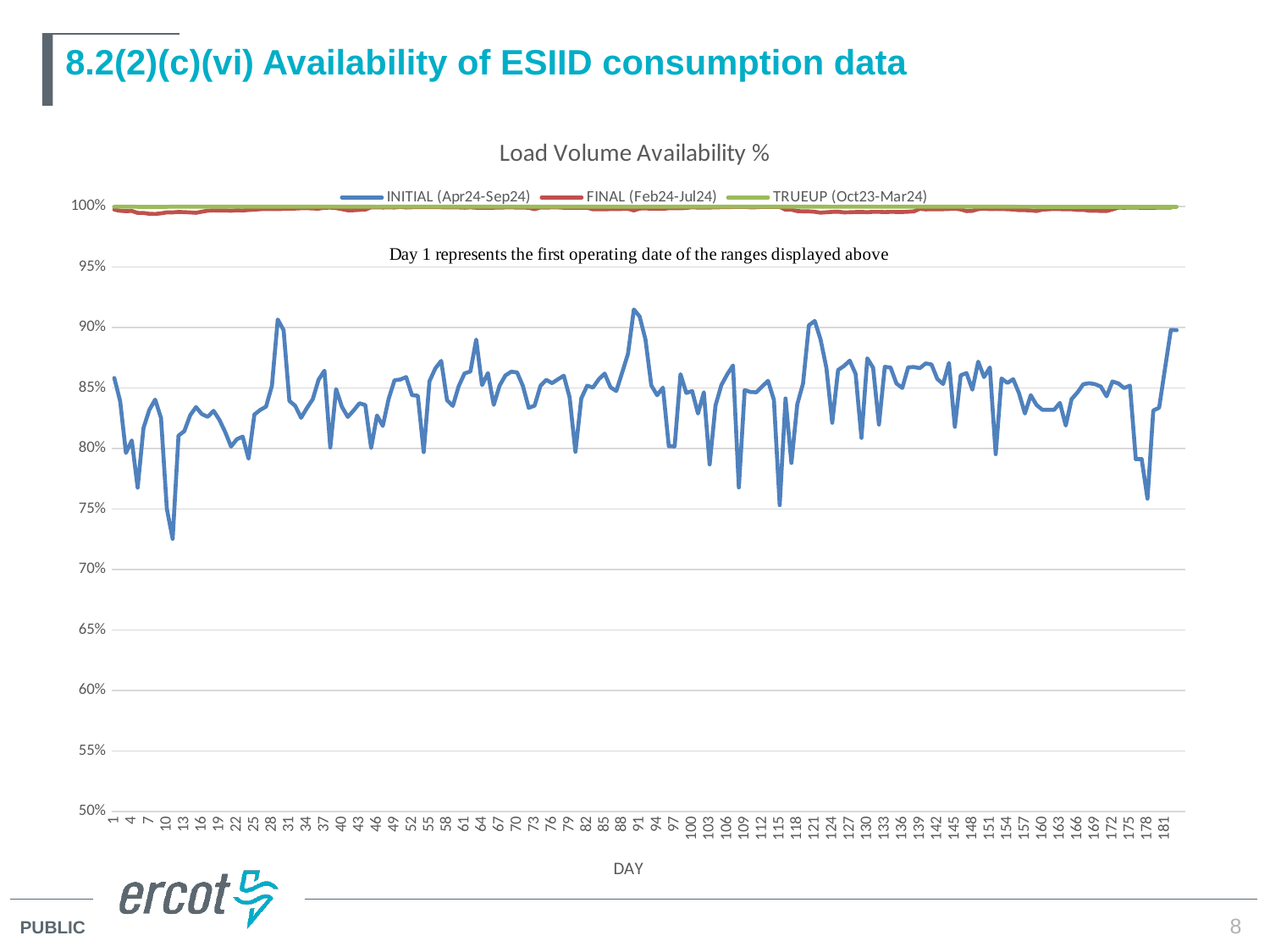
Is the value of the INITIAL (Apr24-Sep24) series at day 178 greater or less than 80%? less What type of chart is shown on the slide? Line chart Which series has the highest values across the chart? TRUEUP (Oct23-Mar24) At day 10, which series has the larger value: INITIAL (Apr24-Sep24) or FINAL (Feb24-Jul24)? FINAL (Feb24-Jul24) Which series has the lowest values across the chart? INITIAL (Apr24-Sep24) Is the value of the INITIAL (Apr24-Sep24) series at day 91 greater or less than 90%? greater What is the title of the chart? Load Volume Availability % Is the value of the FINAL (Feb24-Jul24) series at day 100 greater or less than 95%? greater What is the label of the x axis? DAY How many series does the chart legend list? 3